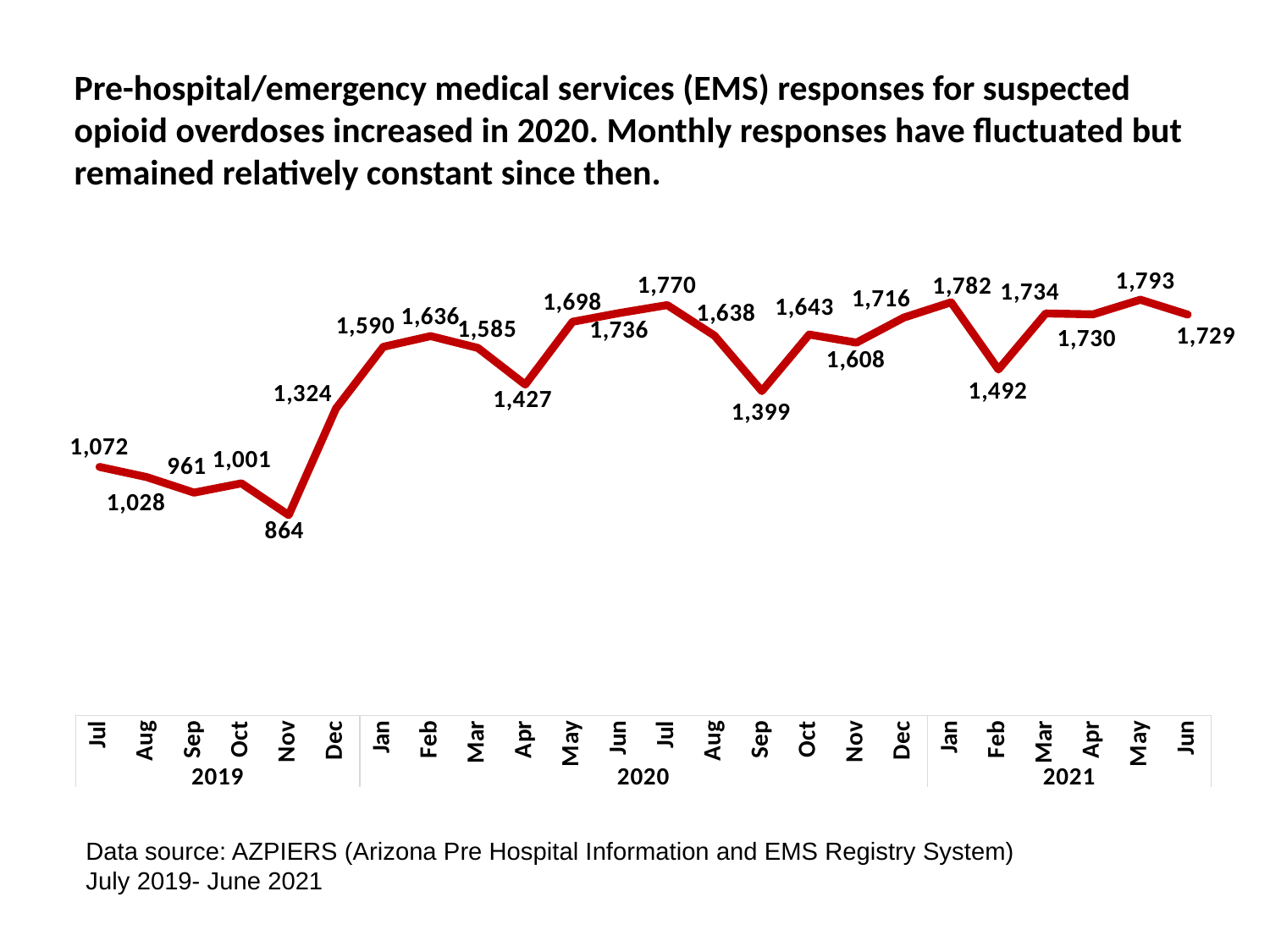
Which month has the lowest value on the chart? Nov 2019 What is the value for Jan 2021? 1,782 How many monthly data points are plotted on the chart? 24 What is the difference between the values for Dec 2019 and Nov 2019? 460 What data source is cited below the chart? AZPIERS (Arizona Pre Hospital Information and EMS Registry System) What type of chart is shown on the slide? line chart Which month has the highest value on the chart? May 2021 What is the difference between the values for Jul 2020 and Jul 2019? 698 Which is larger, the value for Feb 2020 or the value for Feb 2021? Feb 2020 Do the values generally rise or fall from Jul 2019 to Jan 2020? rise What is the value for Sep 2020? 1,399 What is the value for Nov 2019? 864